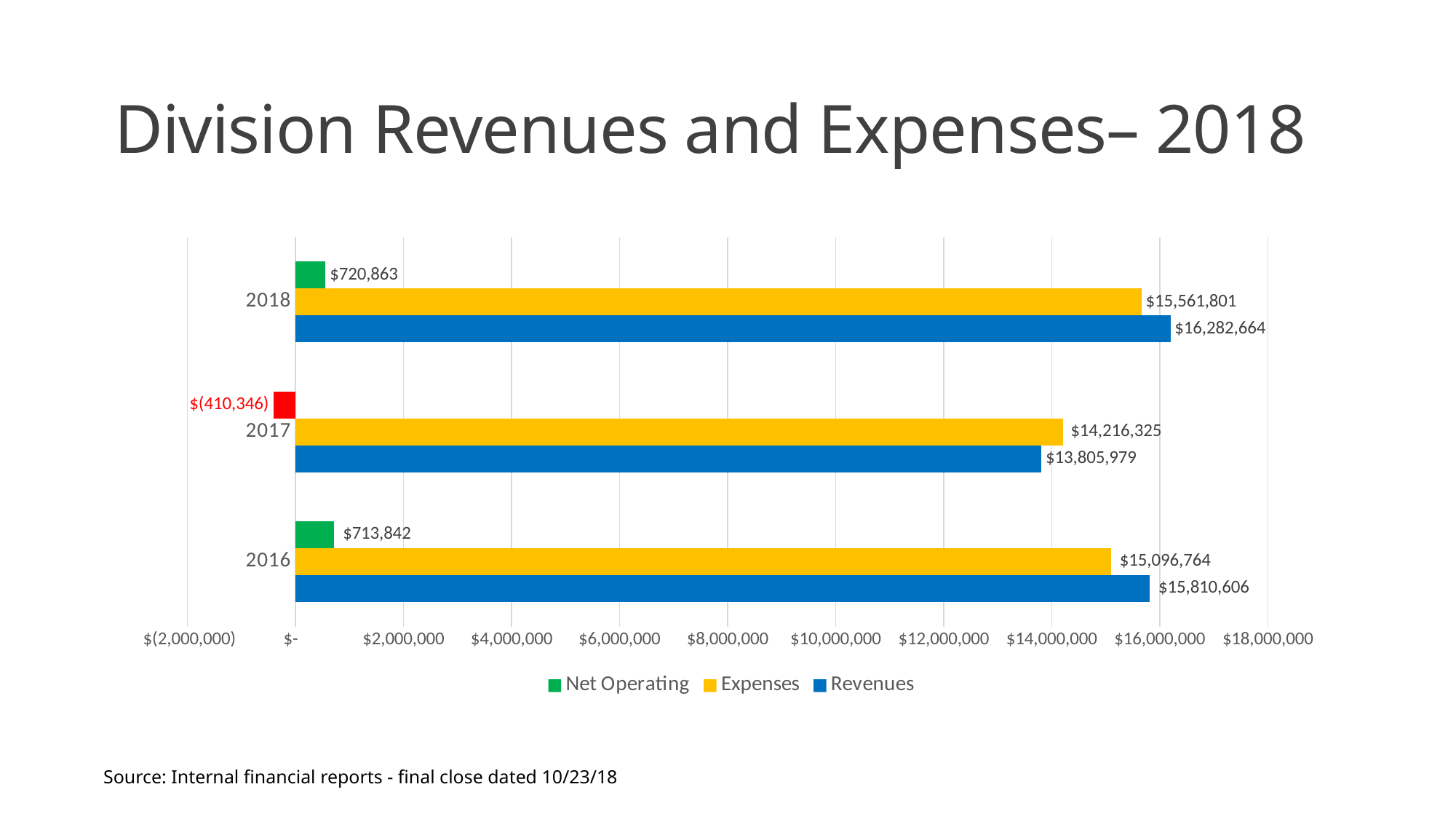
What was the Net Operating value for 2017? $(410,346) What were the Revenues for 2018? $16,282,664 What were the Expenses for 2017? $14,216,325 How many series does the legend list? 3 Which year had the lowest Expenses? 2017 Which year had the highest Revenues? 2018 In 2017, which was larger, Revenues or Expenses? Expenses What was the Net Operating value for 2016? $713,842 What is the difference between Revenues and Expenses in 2018? $720,863 What is the difference between Revenues in 2018 and Revenues in 2016? $472,058 What kind of chart is shown on the slide? Bar chart How many years are shown on the chart? 3